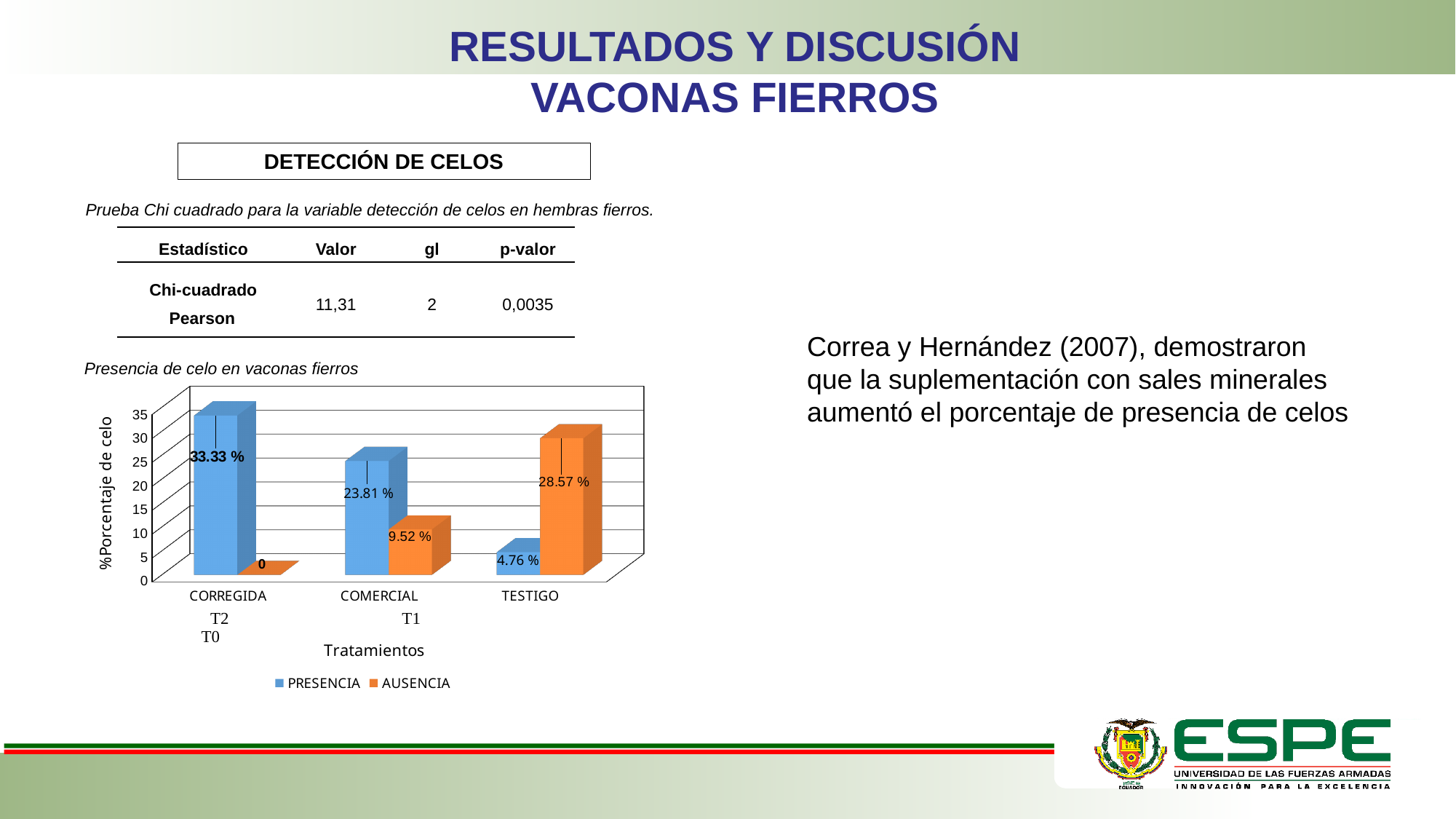
For TESTIGO, which is larger: PRESENCIA or AUSENCIA? AUSENCIA Which treatment has the highest PRESENCIA value? CORREGIDA What is the PRESENCIA value for COMERCIAL? 23.81 % What is the PRESENCIA value for CORREGIDA? 33.33 % How many treatments are shown on the x axis? 3 Which treatment has the lowest PRESENCIA value? TESTIGO What is the difference between the PRESENCIA values for CORREGIDA and COMERCIAL? 9.52 % What kind of chart is shown? Bar chart How many series does the legend list? 2 What is the AUSENCIA value for CORREGIDA? 0 What is the AUSENCIA value for COMERCIAL? 9.52 % What is the AUSENCIA value for TESTIGO? 28.57 %